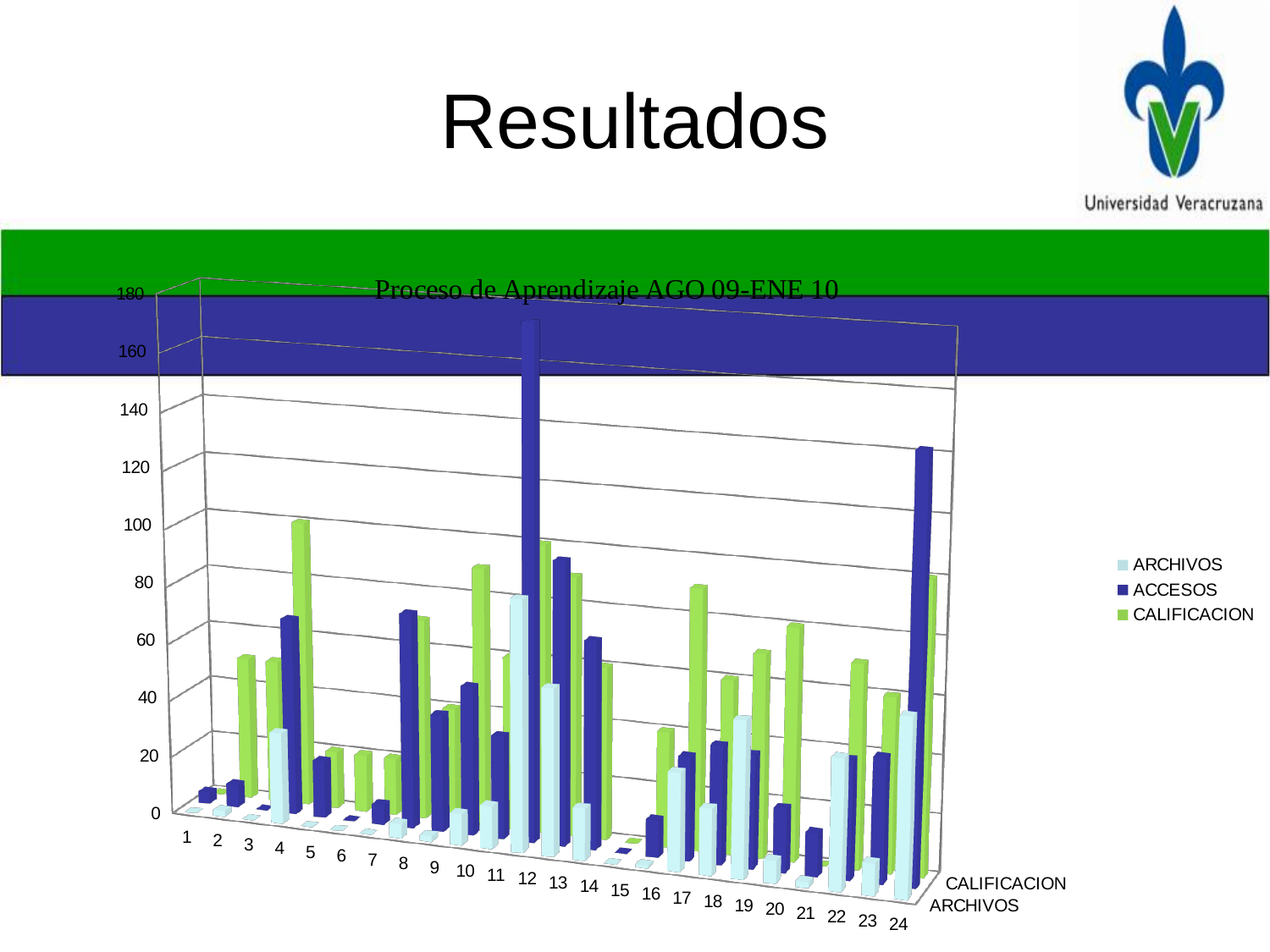
How many categories are shown along the x axis? 24 Is the ACCESOS value for category 12 greater or less than 140? greater How many series does the legend list? 3 Which series are listed in the chart legend? ARCHIVOS, ACCESOS, CALIFICACION Which category has the highest ACCESOS value? 12 Is the ACCESOS value for category 15 greater or less than 20? less Is the ACCESOS value for category 24 greater or less than 100? greater Which has the larger CALIFICACION value, category 4 or category 5? category 4 Which is larger for category 12, ACCESOS or CALIFICACION? ACCESOS What is the title of the chart? Proceso de Aprendizaje AGO 09-ENE 10 What kind of chart is shown on the slide? bar chart